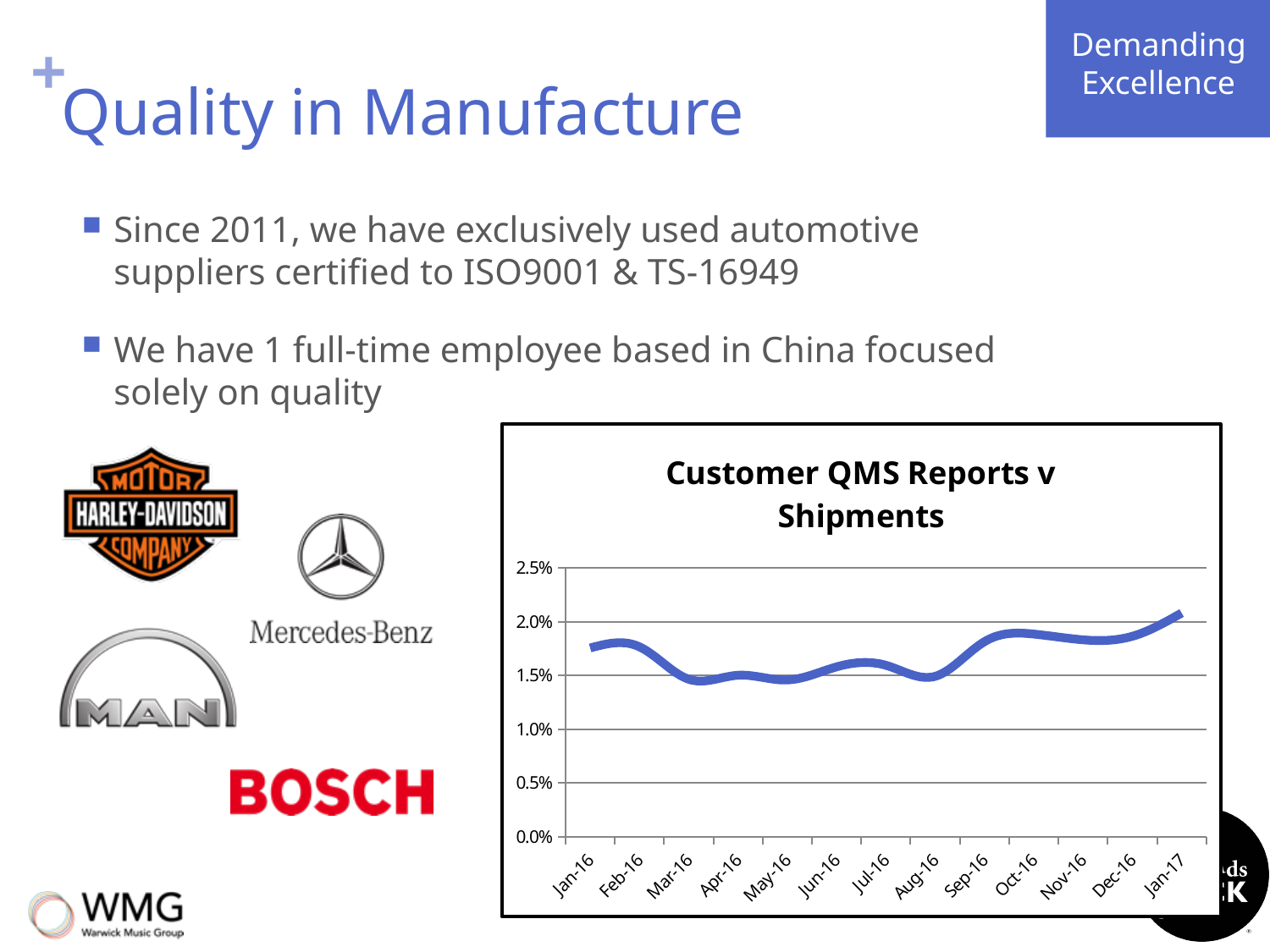
Is the value for Jan-17 greater or less than 2.0%? greater What is the title of the chart? Customer QMS Reports v Shipments What type of chart is shown on the slide? line chart Is the value for Mar-16 greater or less than 2.0%? less Is the value for Jan-16 greater or less than 1.0%? greater Does the line rise or fall from Aug-16 to Jan-17? rise What is the highest value shown on the y axis of the chart? 2.5% How many months are plotted on the x axis of the chart? 13 Which is larger, the value for Oct-16 or the value for Apr-16? Oct-16 Which is larger, the value for Jan-17 or the value for Mar-16? Jan-17 Which month has the highest value in the chart? Jan-17